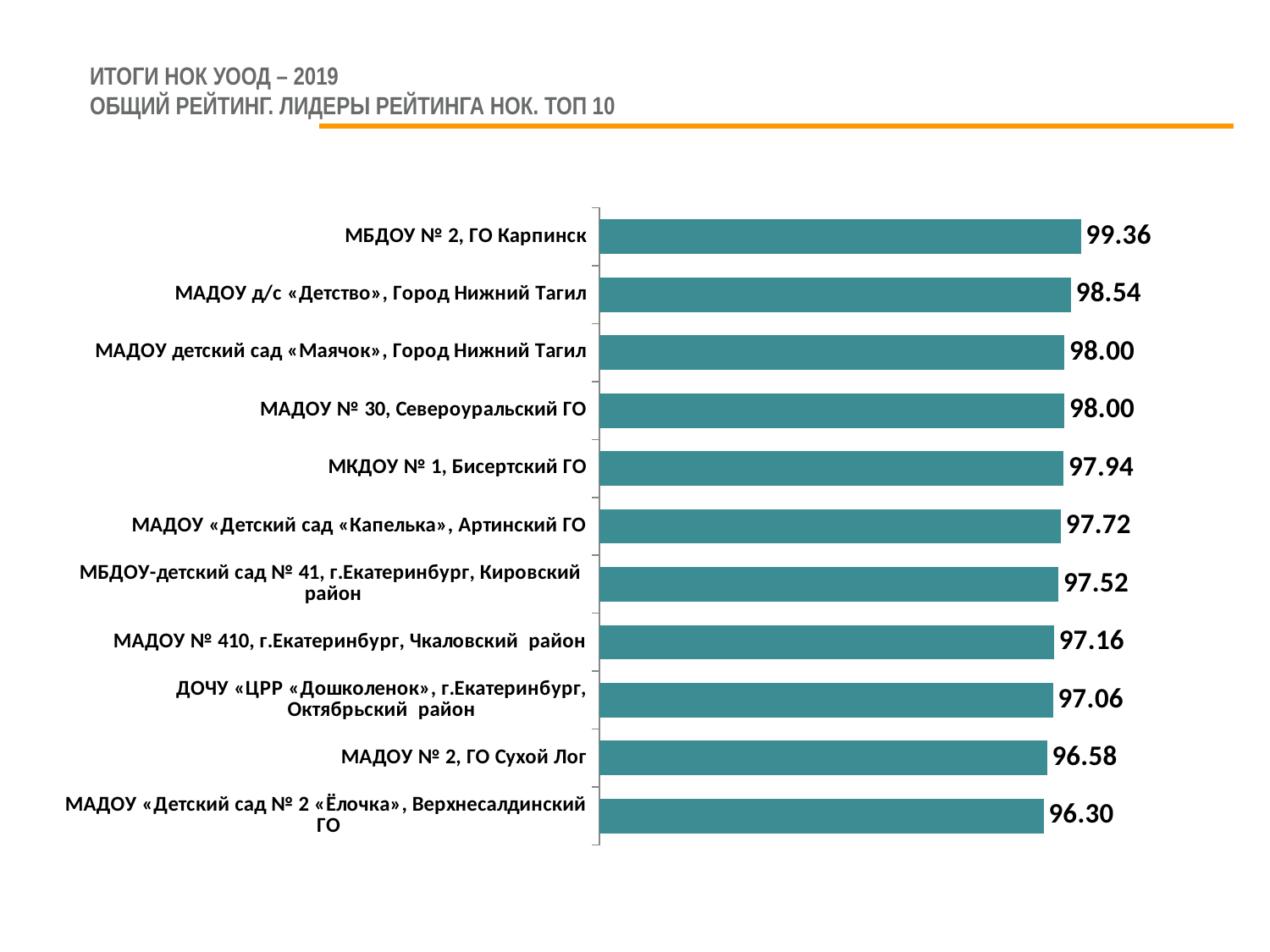
Which category has the highest value? МБДОУ № 2, ГО Карпинск Which has a larger value: МАДОУ «Детский сад «Капелька», Артинский ГО or ДОЧУ «ЦРР «Дошколенок», г.Екатеринбург, Октябрьский район? МАДОУ «Детский сад «Капелька», Артинский ГО What value is shown for МАДОУ № 2, ГО Сухой Лог? 96.58 What is the difference between the values for МАДОУ д/с «Детство», Город Нижний Тагил and МАДОУ № 30, Североуральский ГО? 0.54 Which category has the lowest value? МАДОУ «Детский сад № 2 «Ёлочка», Верхнесалдинский ГО What value is shown for МБДОУ № 2, ГО Карпинск? 99.36 What value is shown for МКДОУ № 1, Бисертский ГО? 97.94 How many bars are plotted on the chart? 11 What kind of chart is shown on the slide? Bar chart Do the values increase or decrease going from the top bar to the bottom bar? Decrease What is the difference between the values for МБДОУ № 2, ГО Карпинск and МАДОУ «Детский сад № 2 «Ёлочка», Верхнесалдинский ГО? 3.06 What value is shown for МАДОУ № 410, г.Екатеринбург, Чкаловский район? 97.16